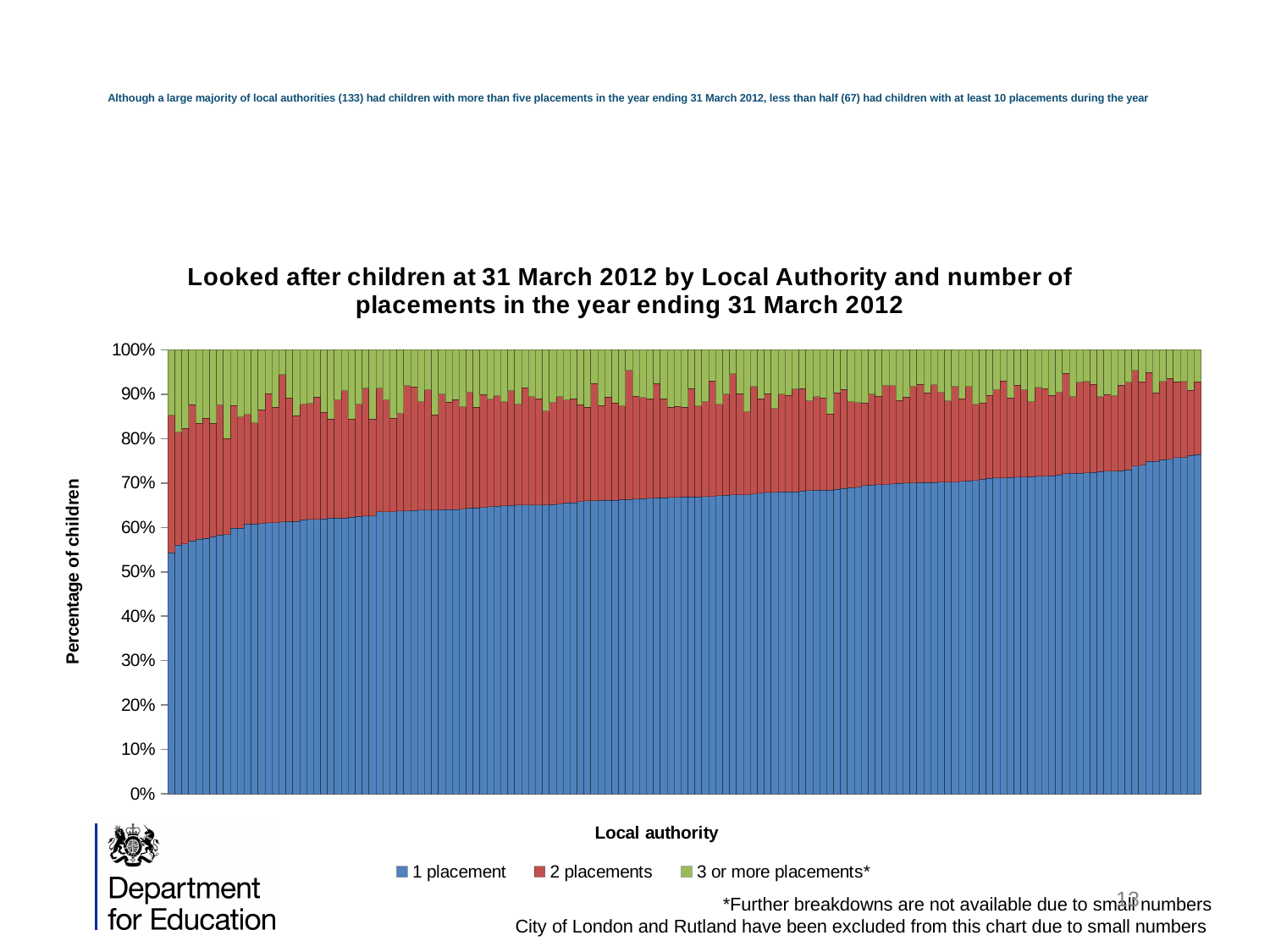
What are the three series listed in the legend? 1 placement, 2 placements, 3 or more placements* What kind of chart is shown on the slide? Stacked bar chart What is the maximum value shown on the vertical axis? 100% Which series is shown in blue? 1 placement Is the 1 placement value for the rightmost local authority greater or less than 70%? greater How many series does the legend list? 3 Does the share of children with 1 placement rise or fall moving from left to right across the local authorities? Rise Is the 1 placement value for the leftmost local authority greater or less than 50%? greater